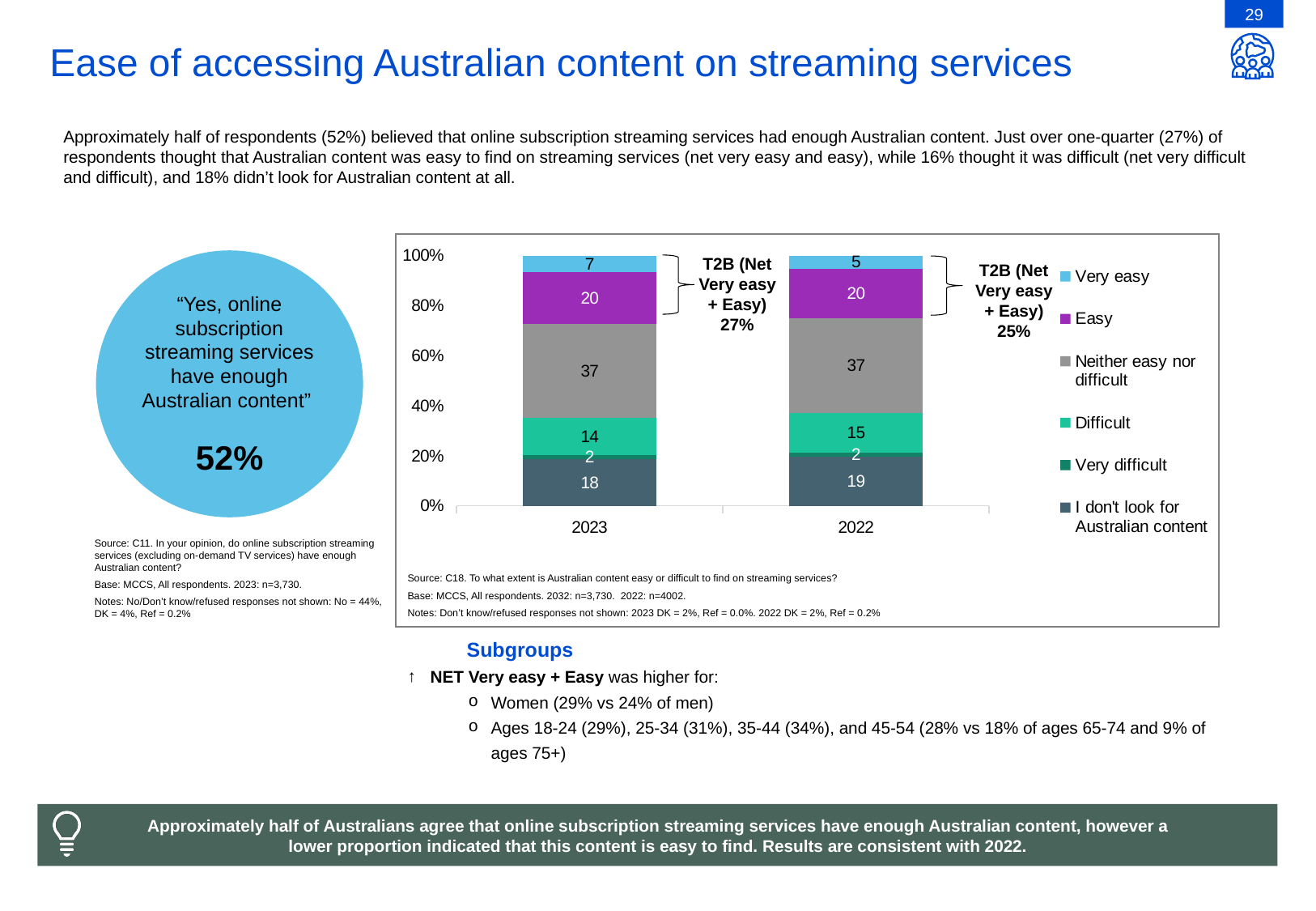
What is the value for 'I don't look for Australian content' in 2022? 19 What kind of chart is shown on the slide? Stacked bar chart What is the value for 'Difficult' in 2023? 14 What is the T2B (Net Very easy + Easy) figure shown for 2023? 27% What is the value for 'Neither easy nor difficult' in 2022? 37 Which segment is the smallest in the 2022 bar? Very difficult Which segment is the largest in the 2023 bar? Neither easy nor difficult How many series does the legend of the bar chart list? 6 How many categories (years) are shown on the x axis of the bar chart? 2 Which year has the larger value for 'Difficult', 2023 or 2022? 2022 What is the value for 'Very easy' in 2023? 7 What is the difference between the 'Very easy' values for 2023 and 2022? 2